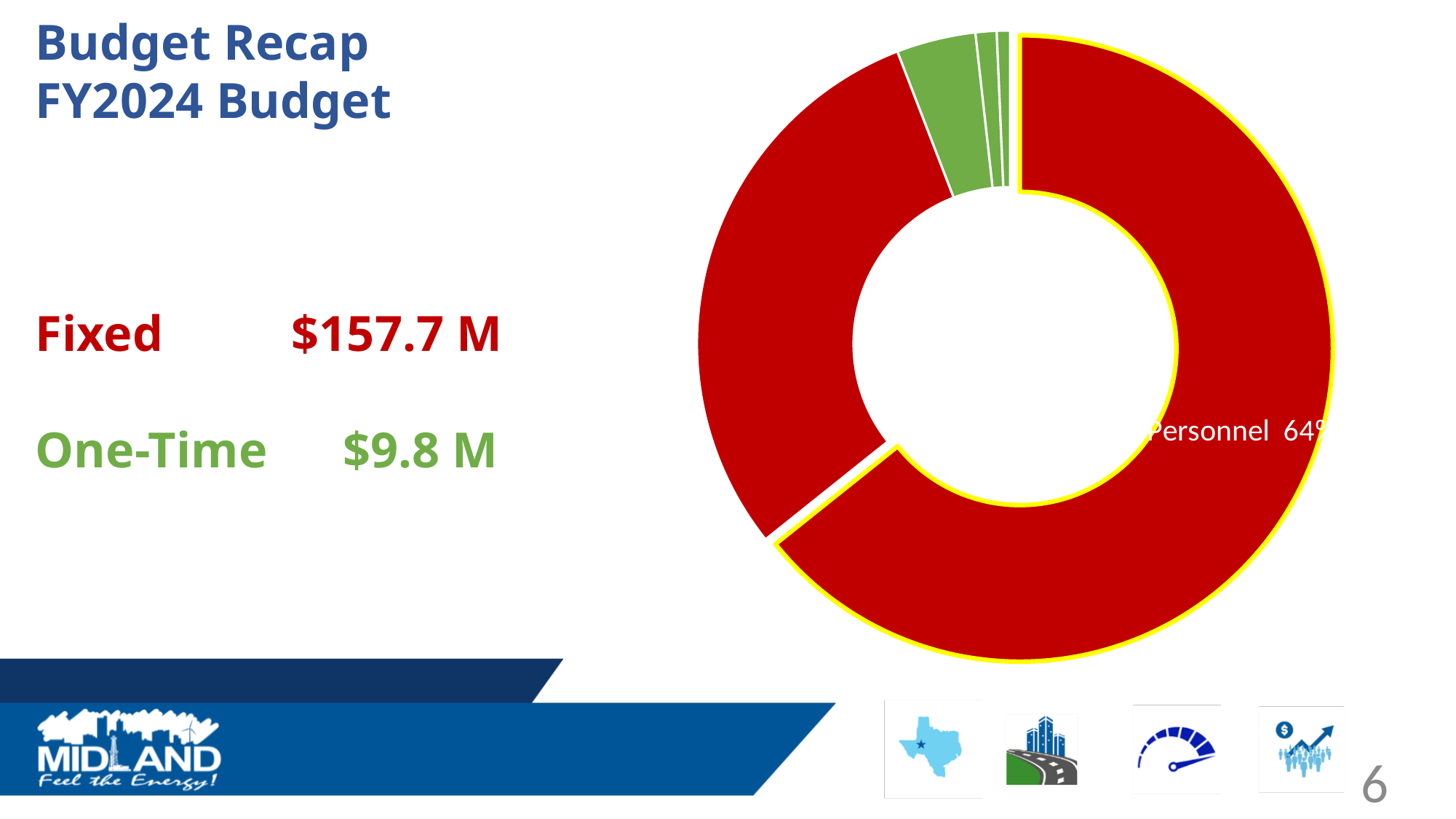
Which is larger on the slide, the Fixed amount or the One-Time amount? Fixed Is the Personnel share of the pie greater or less than 50%? greater What is the One-Time amount shown on the slide? $9.8 M What kind of chart is shown on the slide? pie chart (donut) How many slices does the pie chart have? 5 What share of the pie is labelled for Personnel? 64% What is the difference between the Fixed amount and the One-Time amount shown on the slide? $147.9 M What is the Fixed amount shown on the slide? $157.7 M How many green slices are in the pie chart? 3 What colour is the Personnel slice in the pie chart? red Which slice of the pie chart is the largest? Personnel